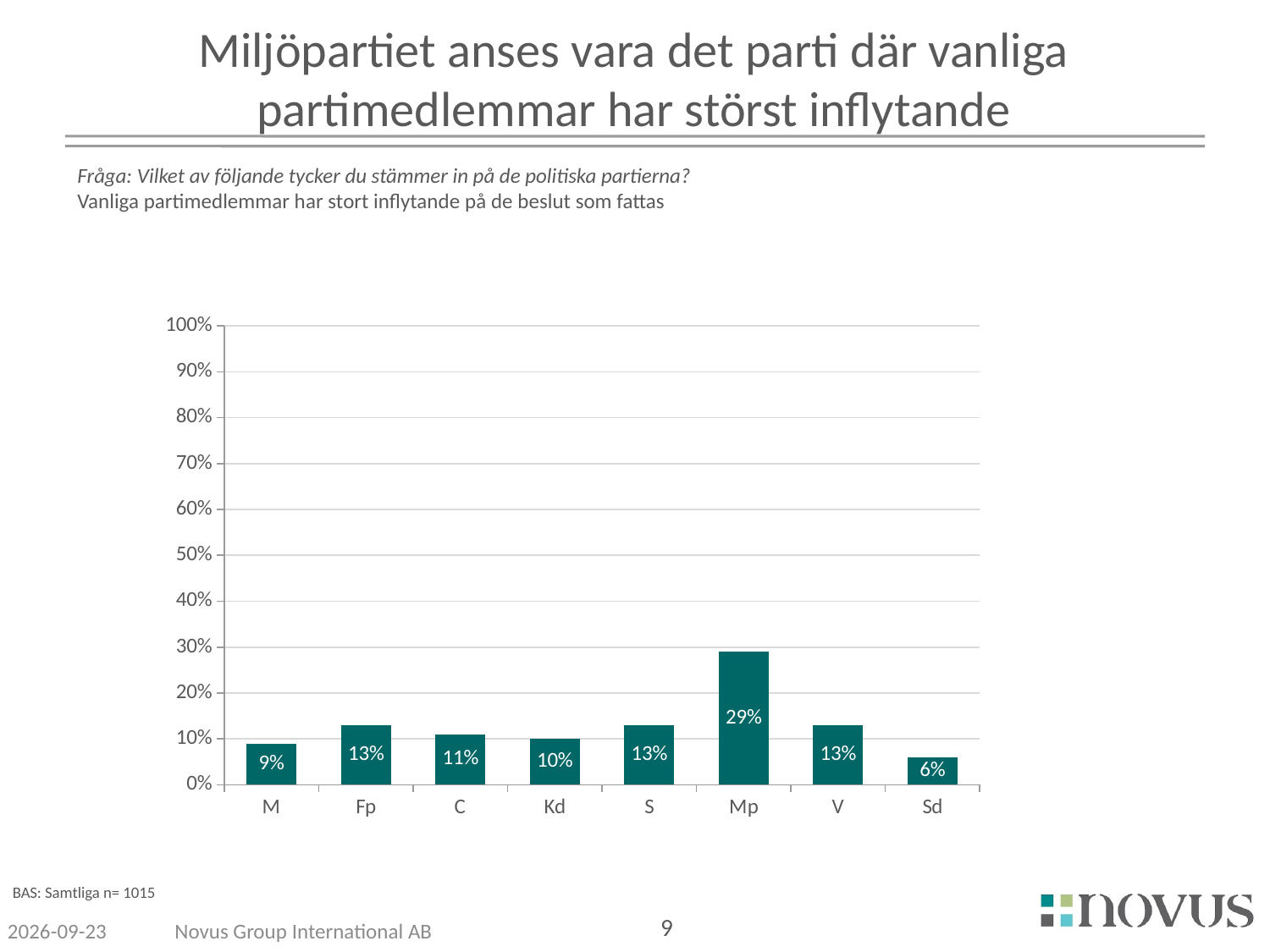
What is the value for C? 11% What is the difference between the values for Fp and Kd? 3% What is the value for Sd? 6% What is the value for Mp? 29% Which party has the lowest value? Sd Which party has the highest value? Mp What kind of chart is shown on the slide? bar chart Which is larger, the value for C or the value for M? C What is the value for M? 9% How many parties are shown on the x axis? 8 Is the value for Mp greater or less than 20%? greater What is the difference between the values for Mp and Sd? 23%